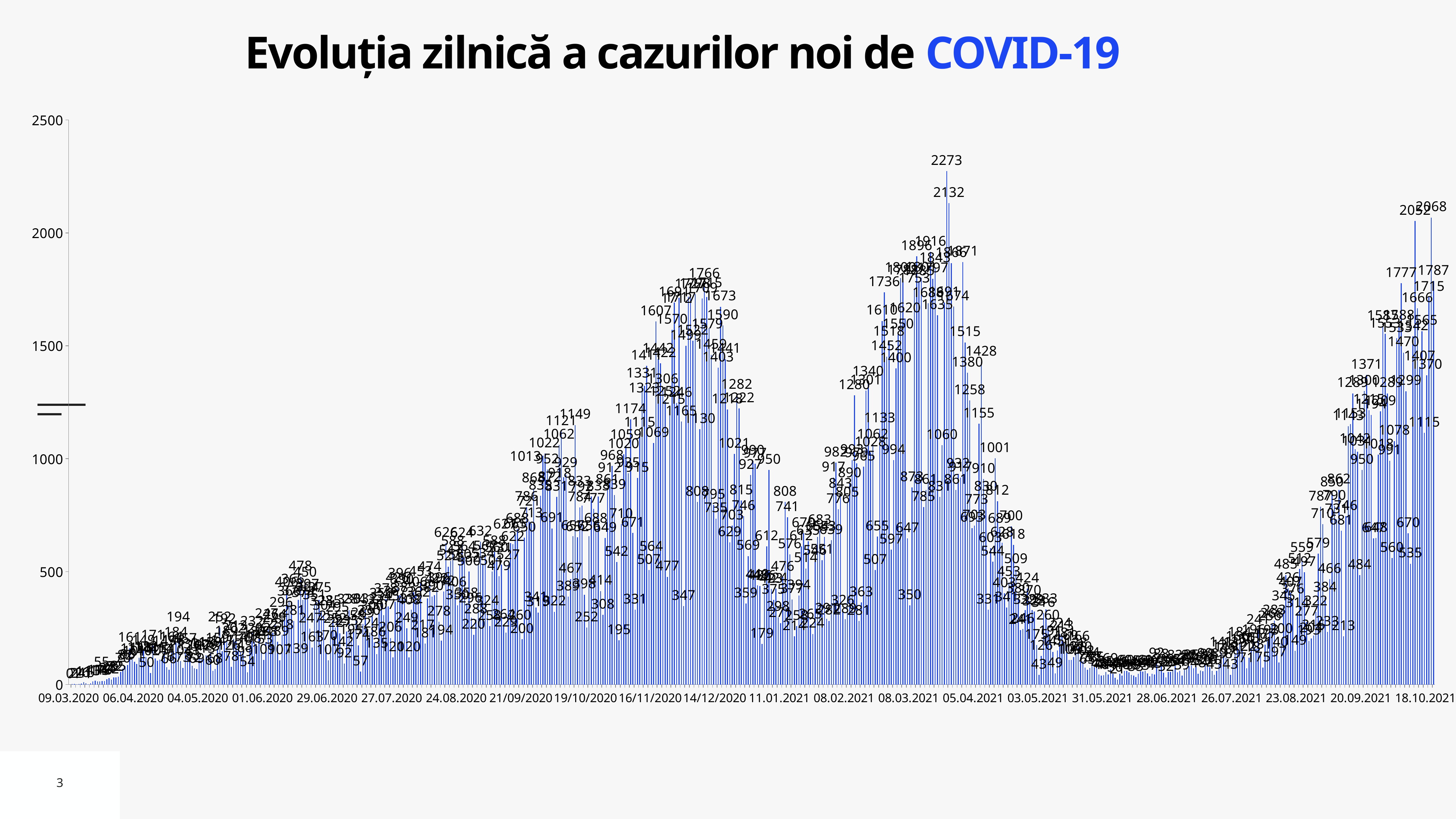
Is the value around 31.05.2021 greater or less than 500? less What kind of chart is shown on the slide? bar chart Which peak is higher: the one around 05.04.2021 or the one around 14/12/2020? the one around 05.04.2021 Do the values rise or fall between 31.05.2021 and 18.10.2021? rise Is the highest bar on the chart greater or less than 2000? greater How many date labels are shown on the x axis? 22 What is the highest tick value on the y axis? 2500 Do the values rise or fall between 05.04.2021 and 31.05.2021? fall What is the difference between the two highest labeled values, 2273 and 2132? 141 What is the highest value labeled on the chart? 2273 What is the second highest value labeled on the chart, next to the 2273 peak? 2132 What is the title of the chart? Evoluția zilnică a cazurilor noi de COVID-19